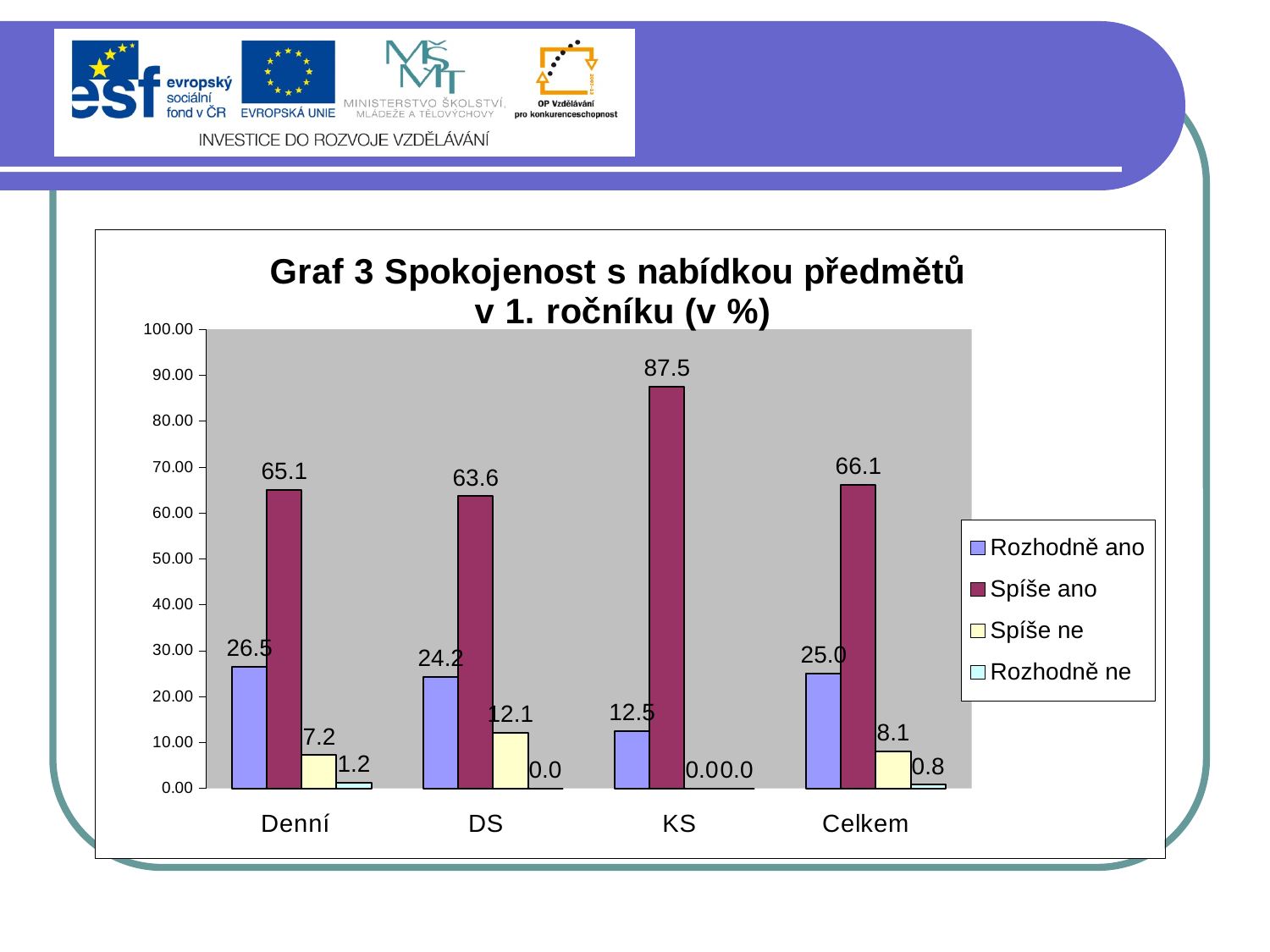
What is the value for Spíše ne in the DS category? 12.1 How many series does the legend list? 4 What is the value for Rozhodně ne in the Celkem category? 0.8 Which category has the lowest value for Rozhodně ano? KS Which is larger, the Rozhodně ano value for Denní or for DS? Denní How many categories are shown on the x axis? 4 Which category has the highest value for Spíše ano? KS What kind of chart is shown on the slide? bar chart What is the difference between the Spíše ano values for KS and Denní? 22.4 What is the value for Rozhodně ano in the Denní category? 26.5 What is the value for Spíše ano in the KS category? 87.5 What is the title of the chart? Graf 3 Spokojenost s nabídkou předmětů v 1. ročníku (v %)